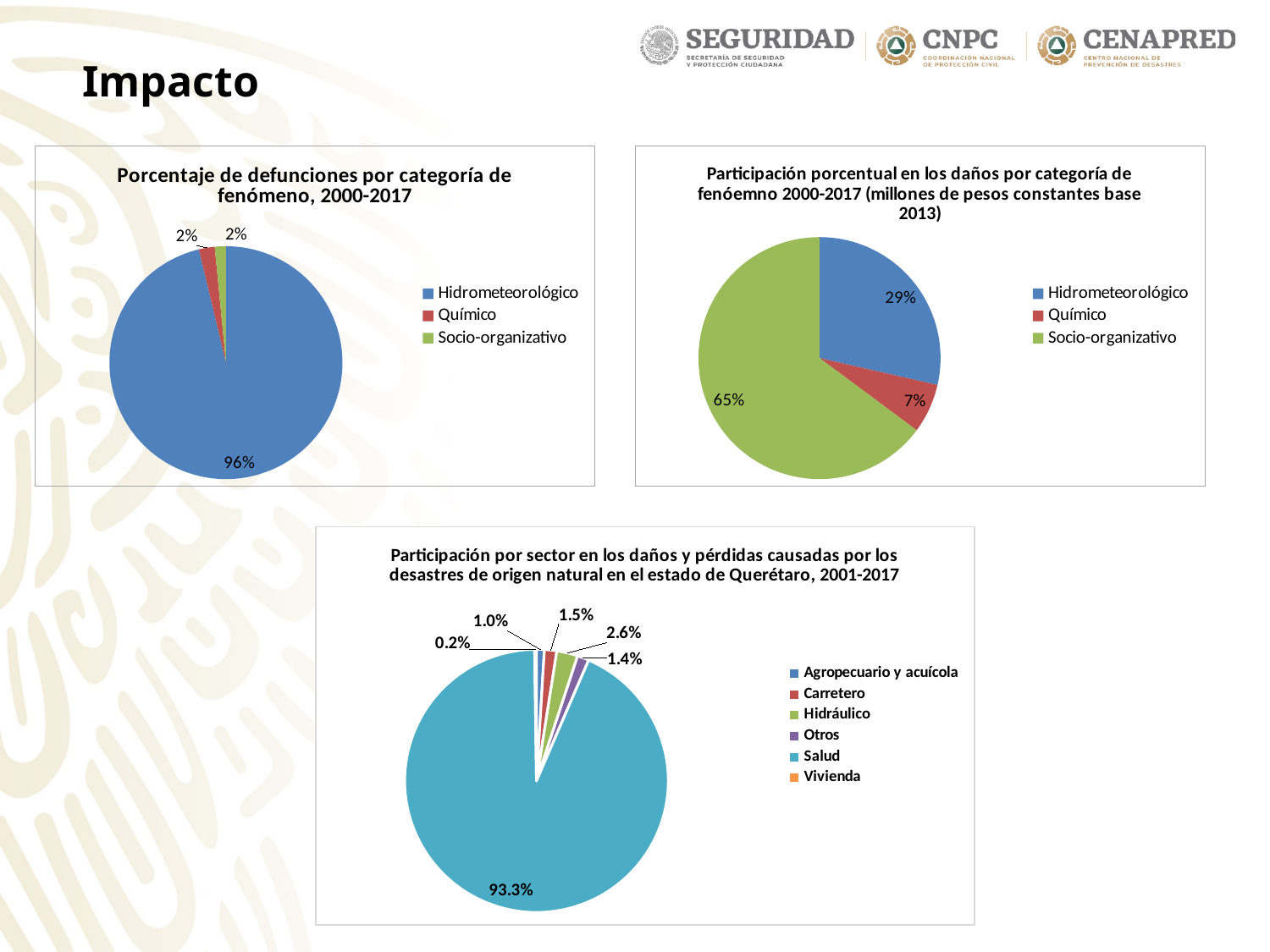
In the bottom chart (Participación por sector en los daños y pérdidas ... Querétaro, 2001-2017), how many sectors does the legend list? 6 In the chart titled 'Porcentaje de defunciones por categoría de fenómeno, 2000-2017', what share is Hidrometeorológico? 96% In the chart titled 'Porcentaje de defunciones por categoría de fenómeno, 2000-2017', which category has the largest share? Hidrometeorológico In the top-right chart (Participación porcentual en los daños por categoría de fenóemno 2000-2017), which category has the smallest share? Químico In the top-right chart (Participación porcentual en los daños por categoría de fenóemno 2000-2017), what share is Socio-organizativo? 65% In the top-right chart (Participación porcentual en los daños por categoría de fenóemno 2000-2017), what share is Químico? 7% What kind of chart is the bottom chart (Participación por sector en los daños y pérdidas ... Querétaro, 2001-2017)? Pie chart In the top-right chart (Participación porcentual en los daños por categoría de fenóemno 2000-2017), which is larger, Hidrometeorológico or Socio-organizativo? Socio-organizativo In the top-right chart (Participación porcentual en los daños por categoría de fenóemno 2000-2017), what is the difference between the Socio-organizativo and Hidrometeorológico shares? 36% In the chart titled 'Porcentaje de defunciones por categoría de fenómeno, 2000-2017', how many categories does the legend list? 3